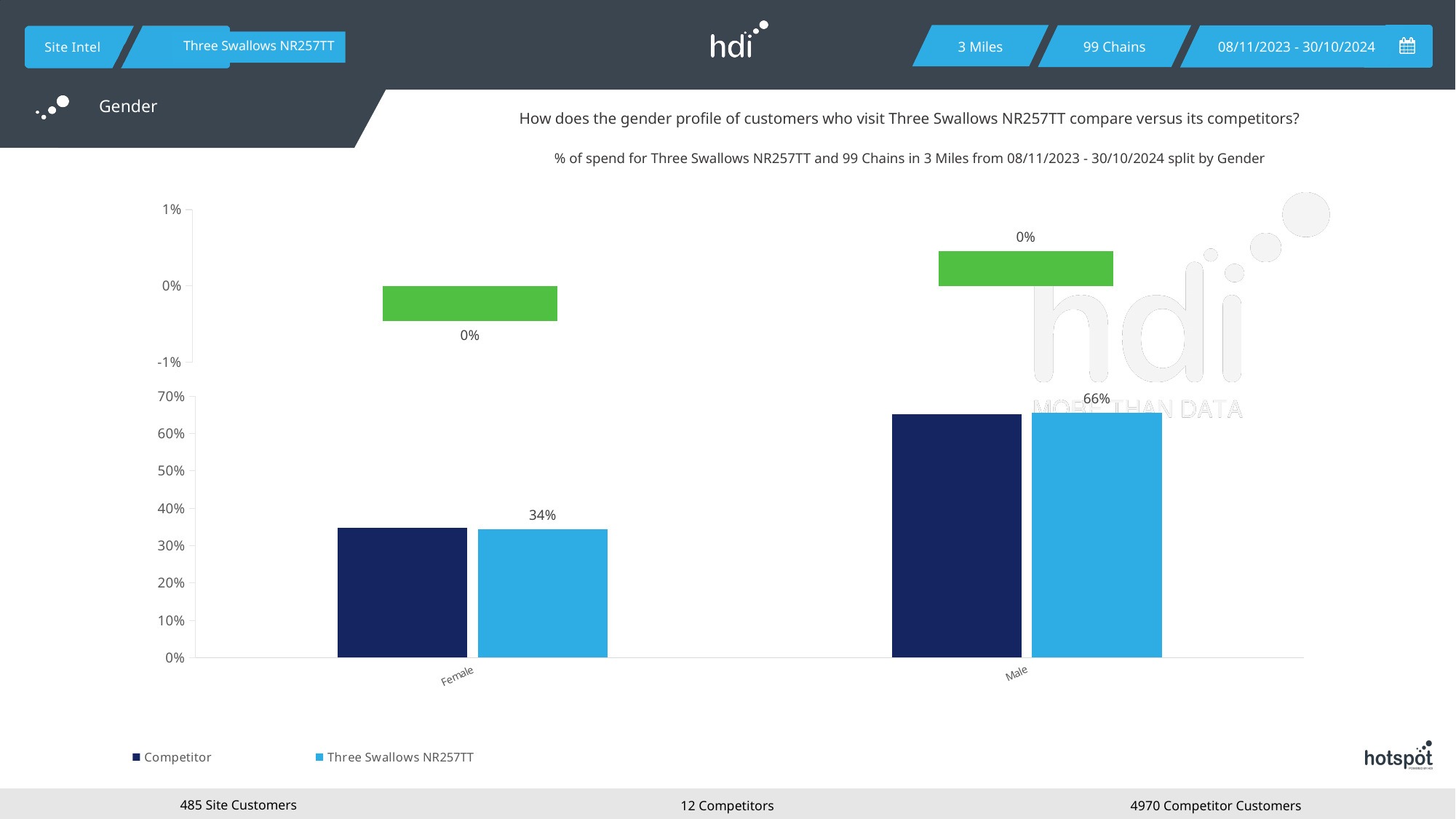
How many series does the legend of the bottom bar chart list? 2 How many gender categories are shown on the x axis of the bottom chart? 2 What kind of chart is the bottom chart on the slide? Bar chart In the bottom bar chart, what is the value for Three Swallows NR257TT for Male? 66% In the bottom bar chart, which gender category has the higher value for Three Swallows NR257TT? Male In the bottom bar chart, is the Competitor value for Female greater or less than 40%? less In the bottom bar chart, what is the value for Three Swallows NR257TT for Female? 34% In the bottom bar chart, which gender category has the lower value for Three Swallows NR257TT? Female In the top chart, what value is labelled on the green bar for Male? 0% In the bottom bar chart, what is the difference between the Three Swallows NR257TT values for Male and Female? 32% In the bottom bar chart, is the Competitor value for Male greater or less than 60%? greater What are the two series names listed in the legend of the bottom chart? Competitor and Three Swallows NR257TT